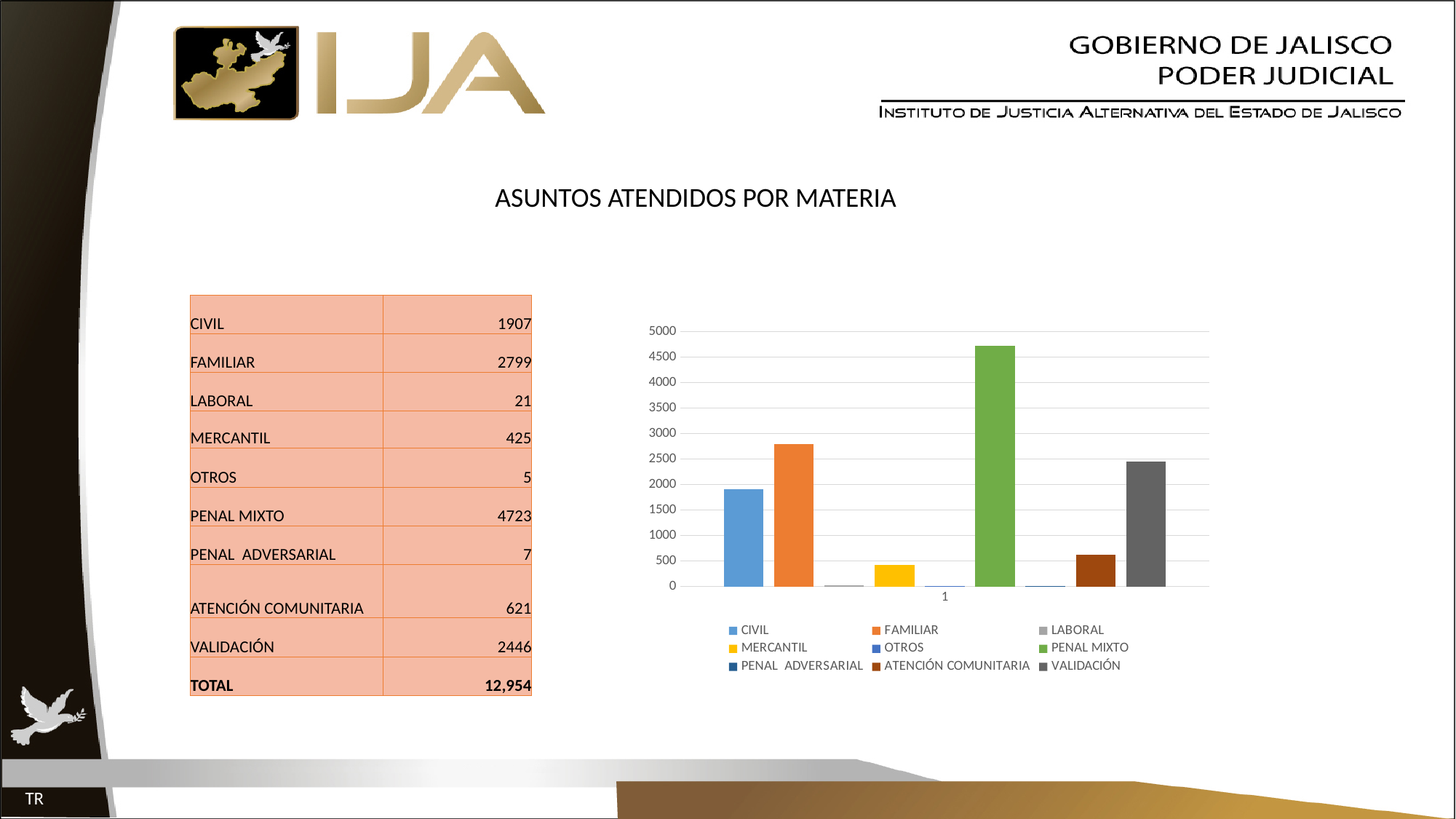
What is the total of all the categories shown on the slide? 12,954 What is the value for FAMILIAR? 2799 What is the value for ATENCIÓN COMUNITARIA? 621 Is the value for MERCANTIL greater or less than 500? less Is the value for FAMILIAR greater or less than 2500? greater Which is larger, the value for CIVIL or the value for VALIDACIÓN? VALIDACIÓN What is the difference between the values for PENAL MIXTO and FAMILIAR? 1924 Which series has the highest value in the chart? PENAL MIXTO What is the value for PENAL MIXTO? 4723 What kind of chart is shown on the slide? bar chart How many series does the chart legend list? 9 What is the title shown above the chart on the slide? ASUNTOS ATENDIDOS POR MATERIA